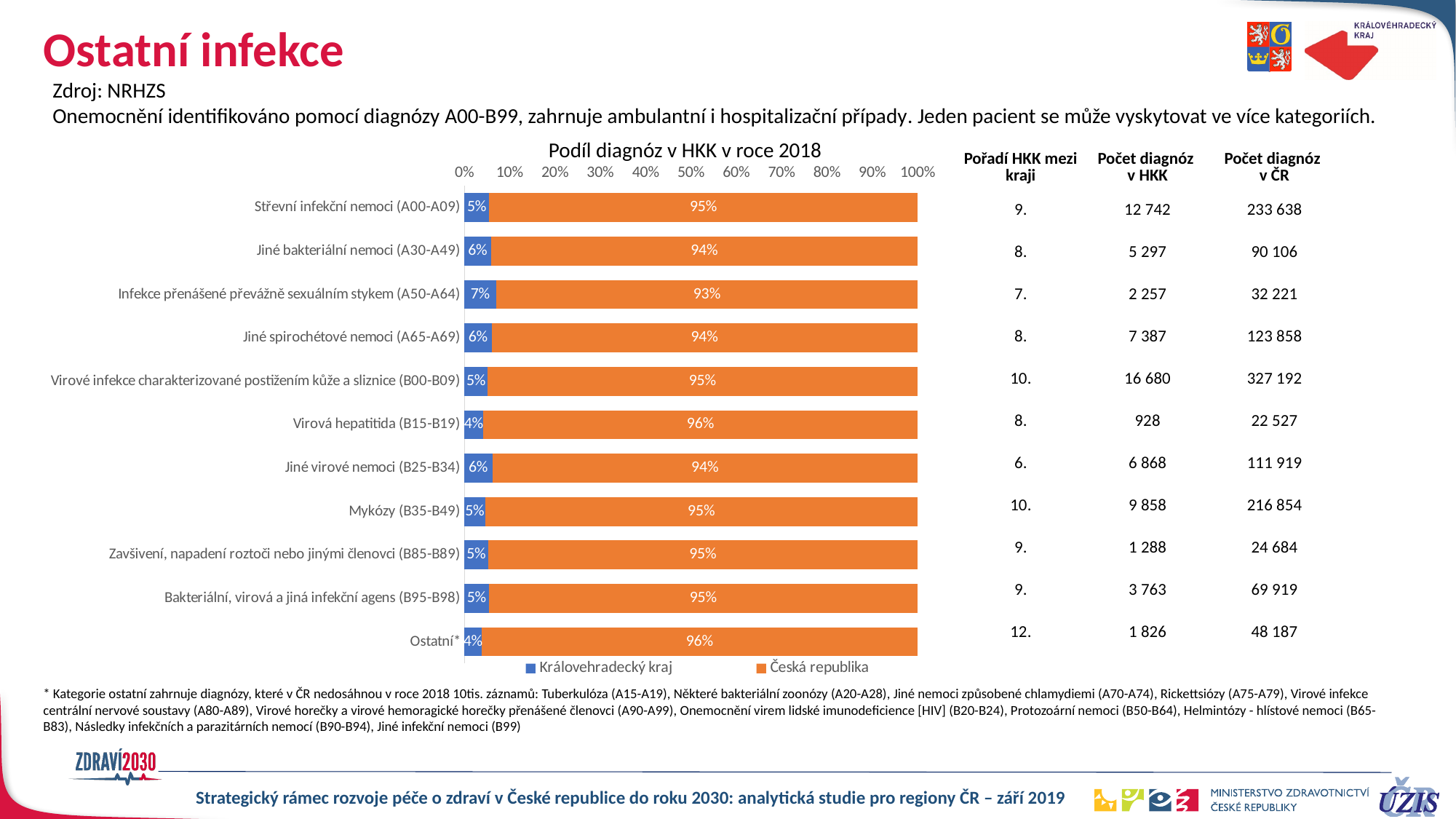
What is the total of the stacked bar for Mykózy (B35-B49)? 100% What is the value for Česká republika in the category Virová hepatitida (B15-B19)? 96% What is the difference between the Česká republika value and the Královehradecký kraj value for Střevní infekční nemoci (A00-A09)? 90% What is the value for Královehradecký kraj in the category Infekce přenášené převážně sexuálním stykem (A50-A64)? 7% What is the value for Královehradecký kraj in the category Jiné virové nemoci (B25-B34)? 6% Which series is shown in orange in the chart? Česká republika How many categories are plotted in the chart? 11 What kind of chart is shown on the slide? bar chart What is the title of the chart? Podíl diagnóz v HKK v roce 2018 How many series does the chart legend list? 2 Which is larger: the Královehradecký kraj value for Jiné bakteriální nemoci (A30-A49) or for Virová hepatitida (B15-B19)? Jiné bakteriální nemoci (A30-A49) Which category has the highest value for Královehradecký kraj? Infekce přenášené převážně sexuálním stykem (A50-A64)